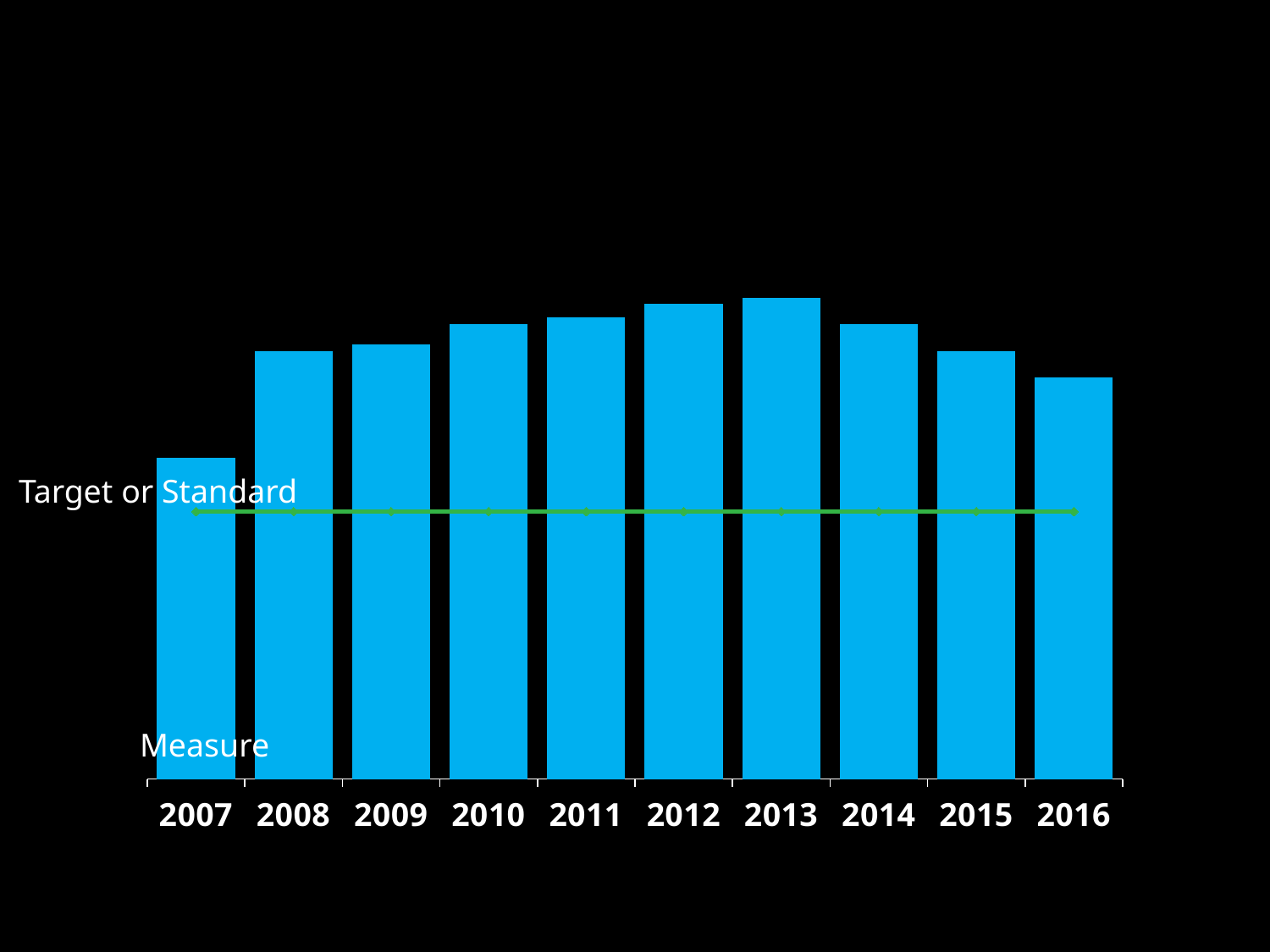
What kind of chart is shown on the slide? combination bar and line chart Which year has the larger value, 2007 or 2008? 2008 Which year has the larger value, 2007 or 2016? 2016 Which year has the larger value, 2009 or 2010? 2010 Which year has the lowest bar in the chart? 2007 How many years are shown on the x axis of the chart? 10 How do the bar values change from 2013 to 2016? They fall How do the bar values change from 2007 to 2013? They rise What does the green horizontal line on the chart represent? Target or Standard What label is given to the blue bars on the chart? Measure Which year has the highest bar in the chart? 2013